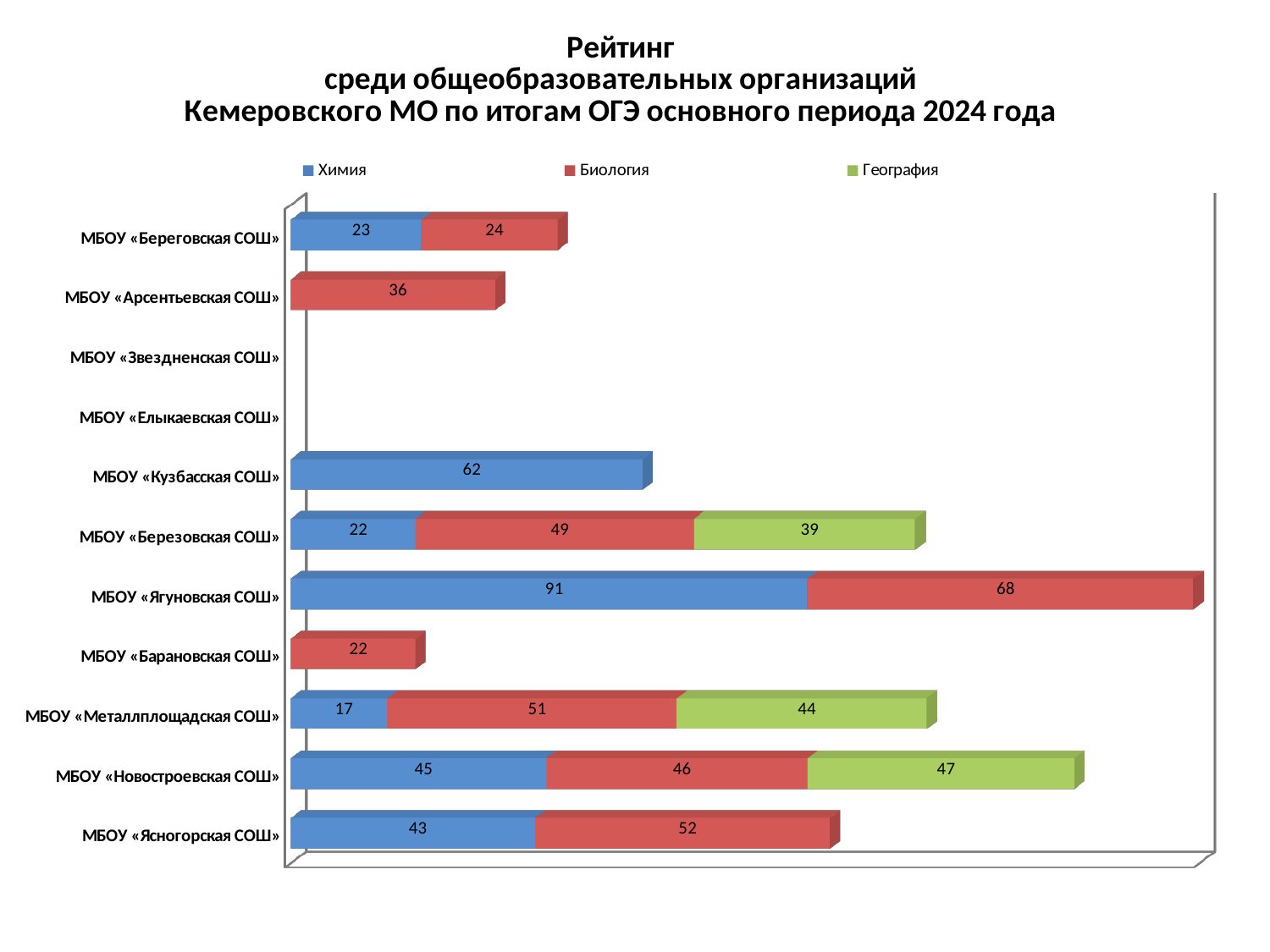
What is the Биология value for МБОУ «Арсентьевская СОШ»? 36 Which school has the highest Химия value? МБОУ «Ягуновская СОШ» What is the difference between the Биология values for МБОУ «Ясногорская СОШ» and МБОУ «Береговская СОШ»? 28 Which series is shown in green in the legend? География What is the География value for МБОУ «Металлплощадская СОШ»? 44 Which school has the lowest Химия value among those with a Химия bar? МБОУ «Металлплощадская СОШ» How many school categories are listed on the vertical axis? 11 What is the Химия value for МБОУ «Ягуновская СОШ»? 91 How many series does the legend list? 3 What is the total of the stacked bar for МБОУ «Новостроевская СОШ»? 138 Which is larger: the Биология value for МБОУ «Березовская СОШ» or the Биология value for МБОУ «Барановская СОШ»? МБОУ «Березовская СОШ» What type of chart is shown on the slide? Stacked bar chart